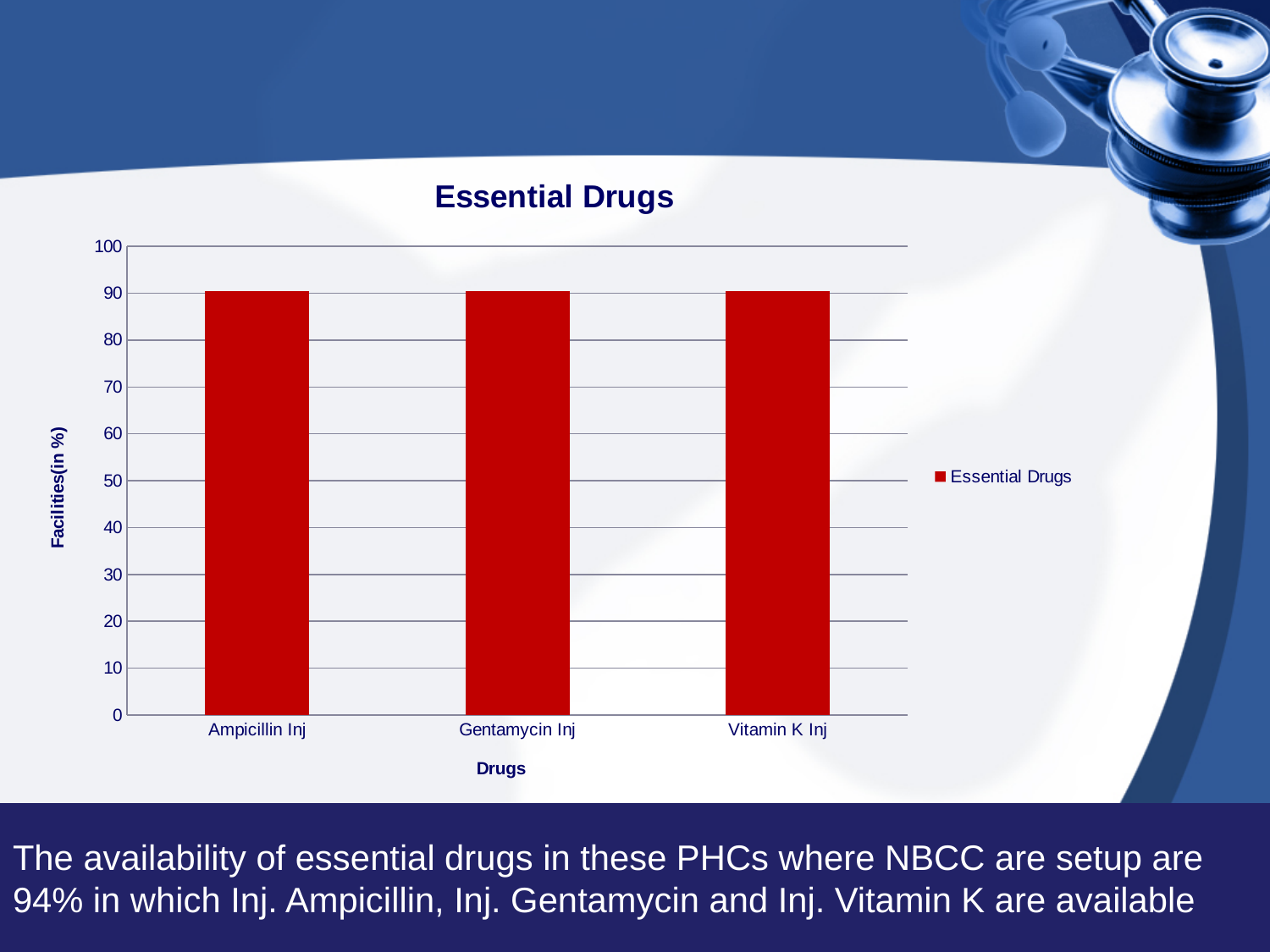
Is the value for Ampicillin Inj greater or less than 80? greater Is the value for Vitamin K Inj greater or less than 50? greater Is the value for Gentamycin Inj greater or less than 100? less What is the title of the chart? Essential Drugs Do the bar values rise, fall, or stay level from Ampicillin Inj to Vitamin K Inj? stay level How many drugs (categories) are plotted on the x axis of the chart? 3 What kind of chart is shown on the slide? bar chart How many series does the legend of the chart list? 1 What is the label of the y axis of the chart? Facilities(in %)